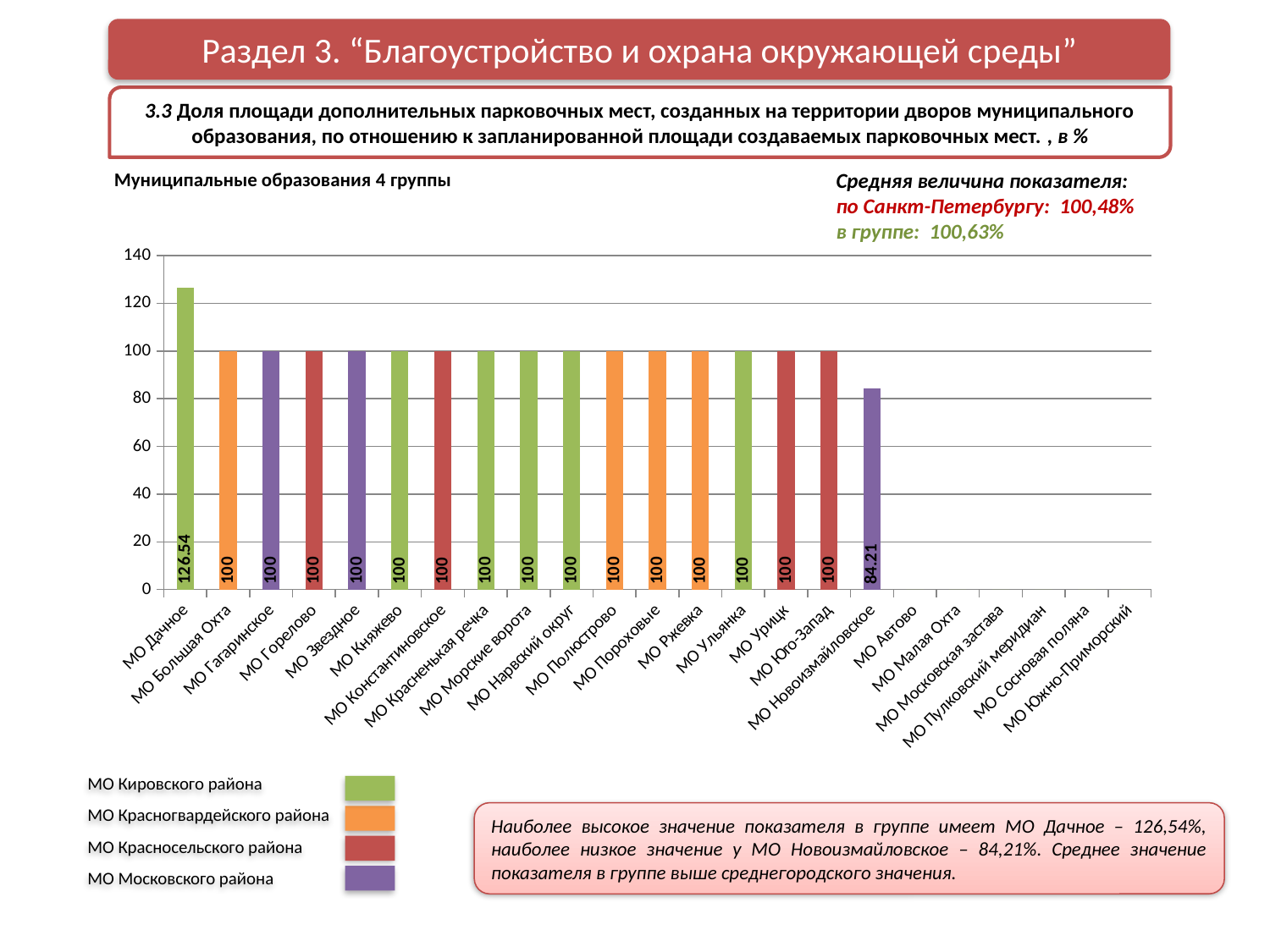
How many municipalities are listed on the x axis of the chart? 23 Is the value for МО Новоизмайловское greater or less than 100? less What is the difference between the values for МО Дачное and МО Новоизмайловское? 42,33 What is the value for МО Новоизмайловское? 84,21 What is the value for МО Дачное? 126,54 Which is larger, the value for МО Дачное or the value for МО Большая Охта? МО Дачное Is the value for МО Дачное greater or less than 120? greater What kind of chart is shown on the slide? bar chart Which municipality with a plotted bar has the lowest value? МО Новоизмайловское What is the value for МО Ульянка? 100 Which municipality has the highest value on the chart? МО Дачное How many district groups does the colour legend below the chart list? 4